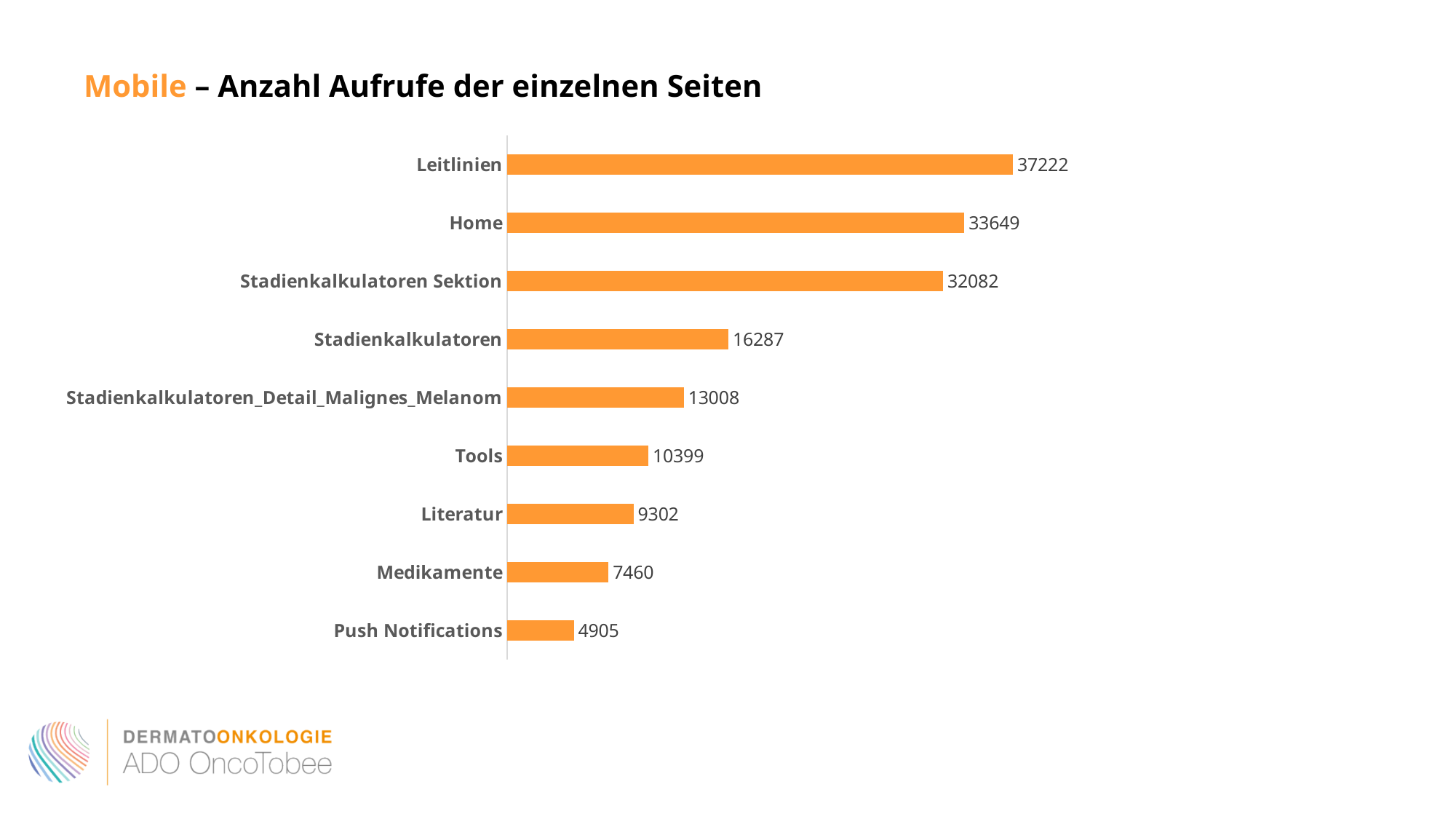
What is the number of page views for Leitlinien? 37222 Which has a larger value, Medikamente or Literatur? Literatur Which page has the lowest number of views? Push Notifications What is the value shown for Stadienkalkulatoren_Detail_Malignes_Melanom? 13008 What is the difference between the values for Leitlinien and Home? 3573 What is the difference between the values for Tools and Literatur? 1097 What kind of chart is shown on the slide? Bar chart Which page has the highest number of views? Leitlinien How many pages (categories) are shown in the chart? 9 What is the title of the slide? Mobile – Anzahl Aufrufe der einzelnen Seiten What is the value shown for Push Notifications? 4905 Which has a larger value, Stadienkalkulatoren Sektion or Stadienkalkulatoren? Stadienkalkulatoren Sektion